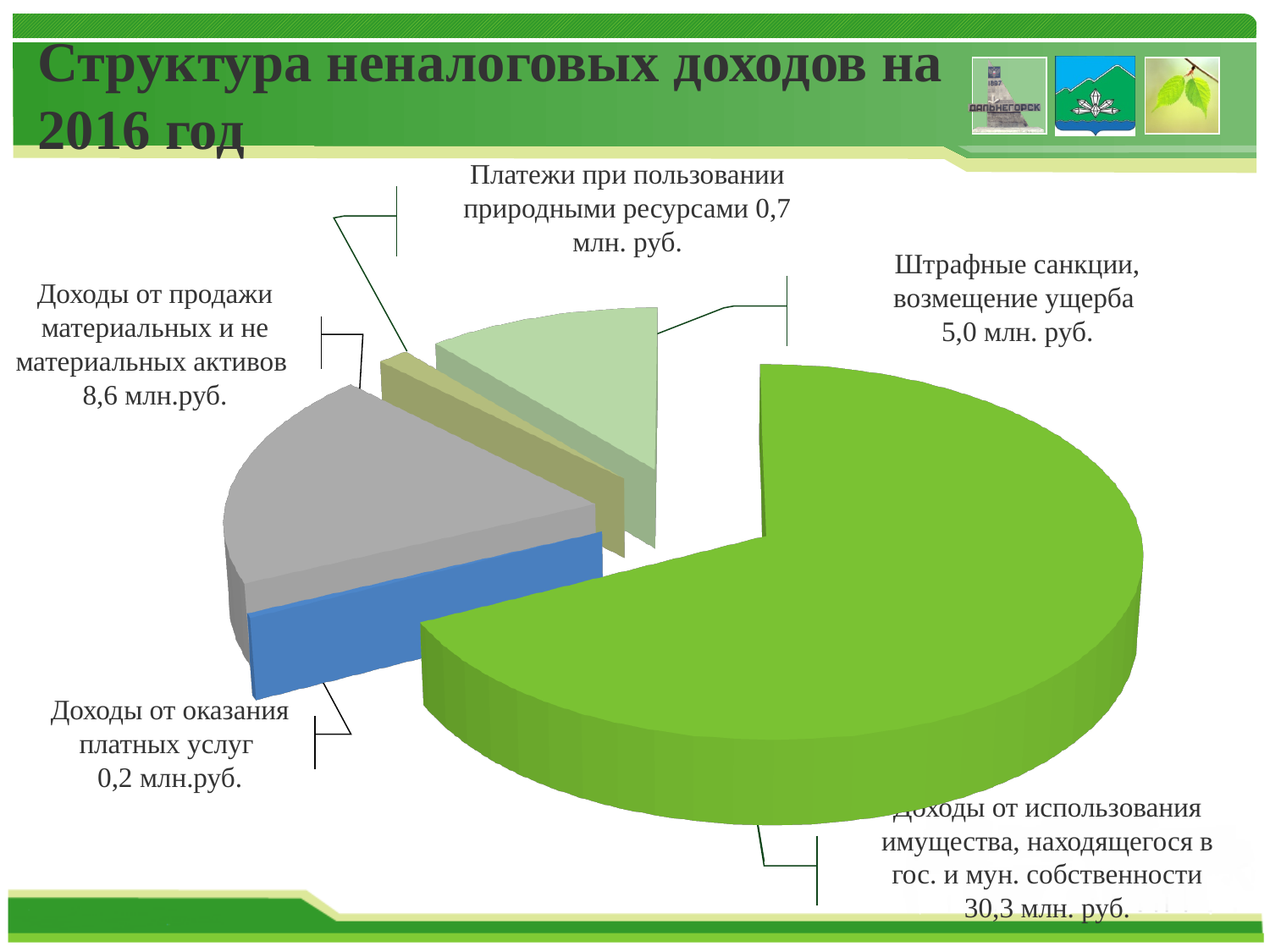
Which is larger: "Штрафные санкции, возмещение ущерба" or "Доходы от продажи материальных и не материальных активов"? Доходы от продажи материальных и не материальных активов What is the value for "Доходы от использования имущества, находящегося в гос. и мун. собственности"? 30,3 млн. руб. Which category has the smallest slice of the pie? Доходы от оказания платных услуг What is the value for "Штрафные санкции, возмещение ущерба"? 5,0 млн. руб. How many slices does the pie chart have? 5 What is the difference between "Доходы от использования имущества" (30,3 млн. руб.) and "Доходы от продажи материальных и не материальных активов" (8,6 млн.руб.)? 21,7 млн. руб. What is the title of the slide containing the chart? Структура неналоговых доходов на 2016 год Which category has the largest slice of the pie? Доходы от использования имущества, находящегося в гос. и мун. собственности What is the value for "Доходы от оказания платных услуг"? 0,2 млн.руб. What is the value for "Доходы от продажи материальных и не материальных активов"? 8,6 млн.руб. What is the value for "Платежи при пользовании природными ресурсами"? 0,7 млн. руб. What type of chart is shown on the slide? Pie chart